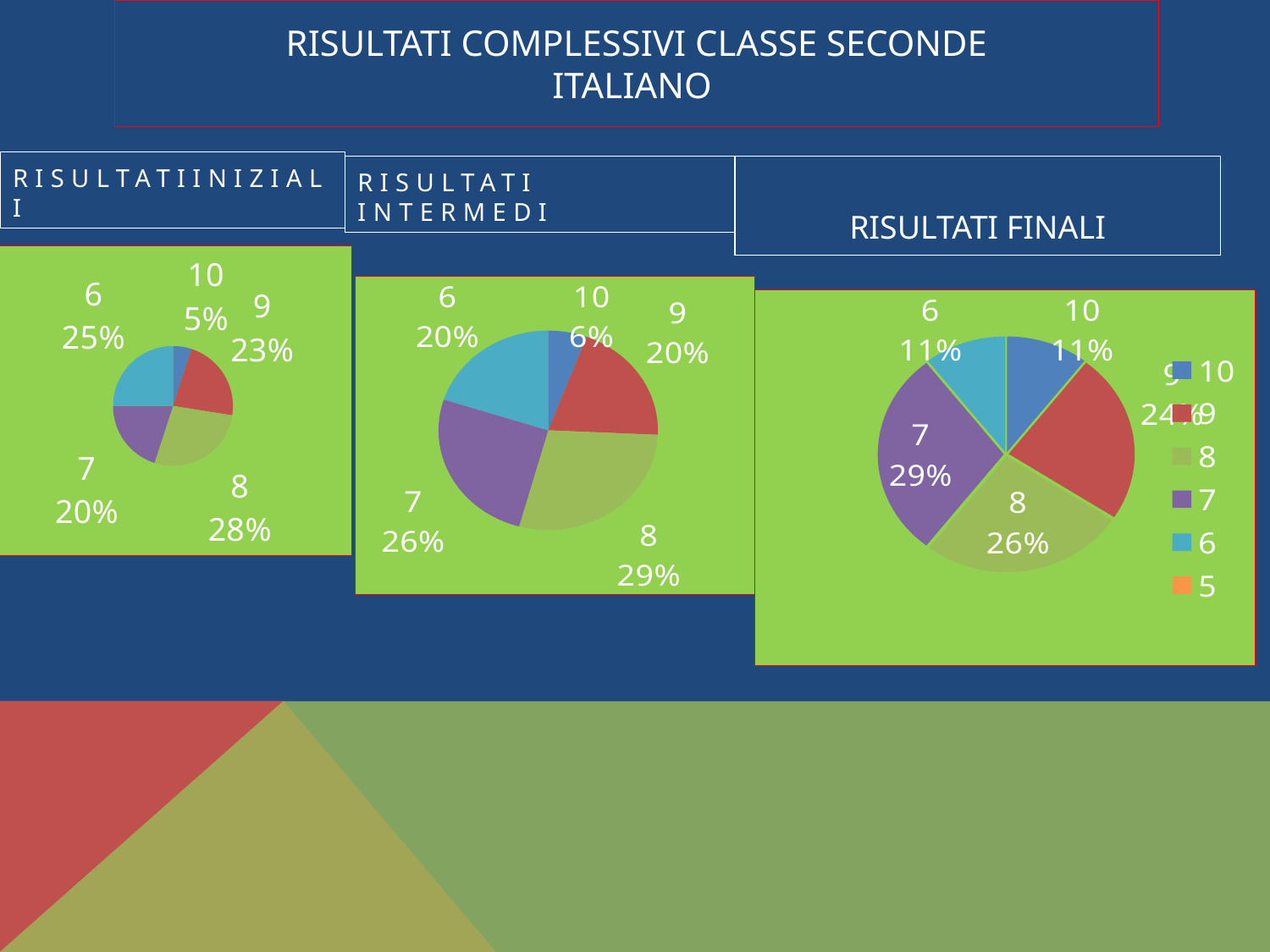
How many entries does the legend of the RISULTATI FINALI chart list? 6 How many slices are labelled in the RISULTATI INIZIALI pie chart? 5 In the RISULTATI INTERMEDI pie chart, what share is labelled for category 10? 6% In the RISULTATI INTERMEDI pie chart, which category has the largest share? 8 In the RISULTATI INIZIALI pie chart, what is the difference between the shares for 6 and 7? 5% In the RISULTATI INIZIALI pie chart, which category has the smallest share? 10 In the RISULTATI FINALI pie chart, which is larger, the share for 8 or the share for 10? 8 In the RISULTATI FINALI pie chart, what share is labelled for category 7? 29% What kind of chart is used for RISULTATI INTERMEDI? Pie chart In the RISULTATI FINALI pie chart, what share is labelled for category 6? 11% In the RISULTATI INIZIALI pie chart, what share is labelled for category 8? 28% In the RISULTATI INTERMEDI pie chart, what share is labelled for category 7? 26%